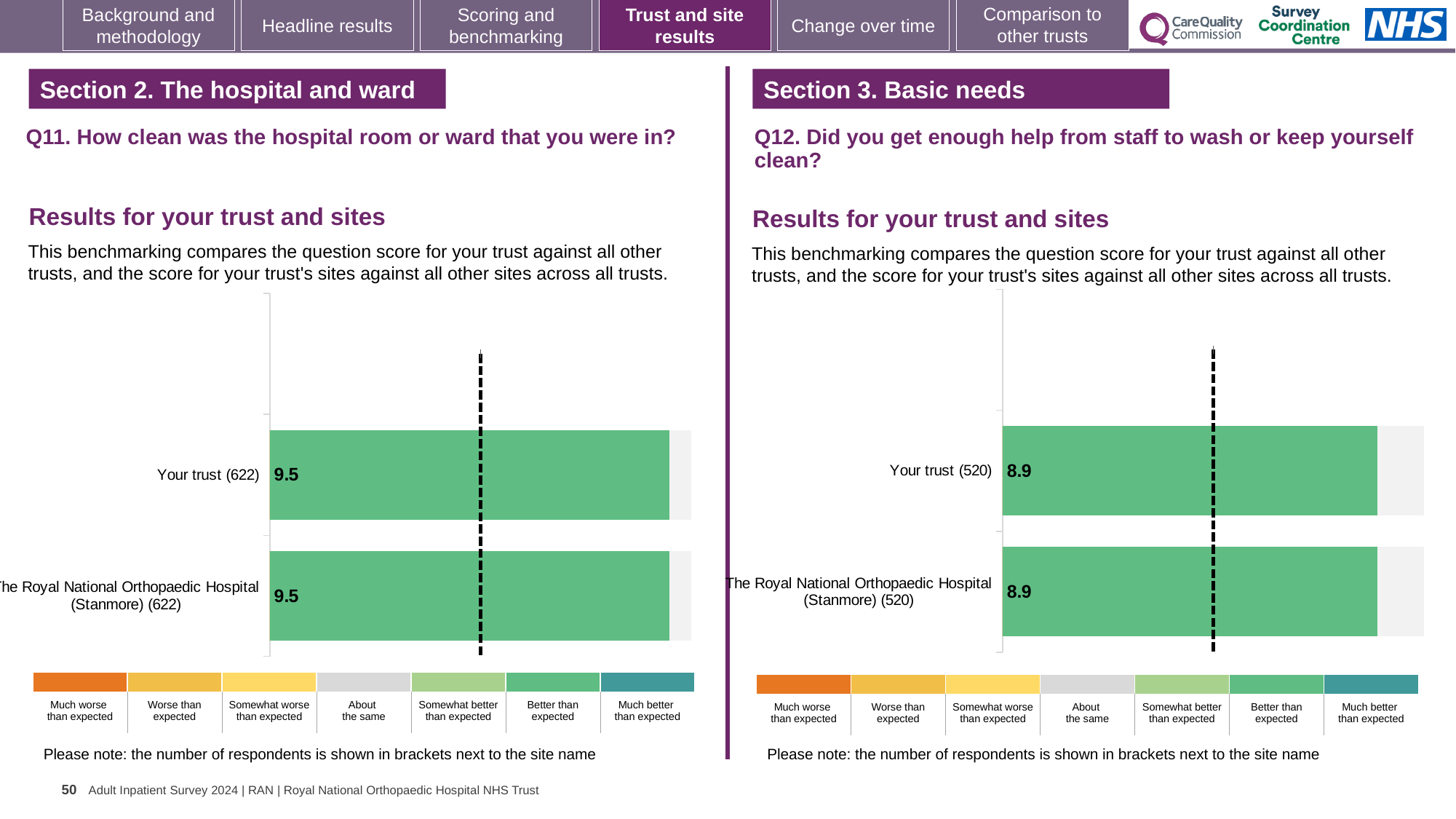
On the Q12 chart (right), what is the difference between the score for Your trust and the score for The Royal National Orthopaedic Hospital (Stanmore)? 0 Is the score for Your trust on the Q12 chart (right) larger or smaller than the score for Your trust on the Q11 chart (left)? Smaller On the Q12 chart (right), what is the score for Your trust? 8.9 On the Q11 chart (left), what is the difference between the score for Your trust and the score for The Royal National Orthopaedic Hospital (Stanmore)? 0 On the Q12 chart (right), what is the score for The Royal National Orthopaedic Hospital (Stanmore)? 8.9 On the Q11 chart (left), how many respondents are shown in brackets next to Your trust? 622 On the Q12 chart (right), how many respondents are shown in brackets next to The Royal National Orthopaedic Hospital (Stanmore)? 520 On the Q11 chart (left), what is the score for The Royal National Orthopaedic Hospital (Stanmore)? 9.5 On the Q11 chart (left), what is the score for Your trust? 9.5 How many bars are plotted on the Q12 chart (right)? 2 What kind of chart is used for the Q11 results on the left? Bar chart How many bars are plotted on the Q11 chart (left)? 2